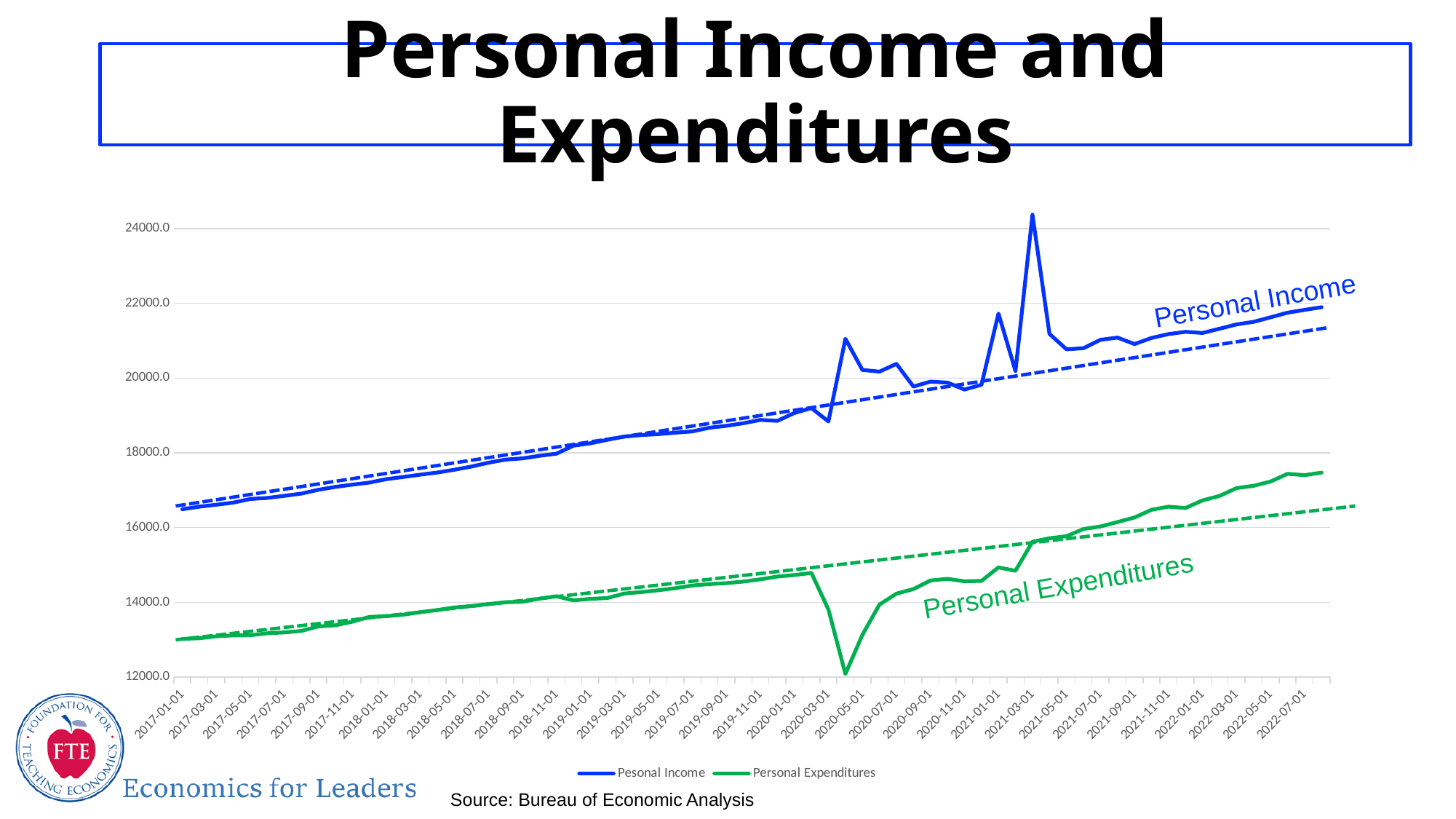
Is the value of Personal Expenditures at 2022-07-01 greater or less than 16000? greater Which series has higher values throughout the chart, Personal Income or Personal Expenditures? Personal Income What colour is the Personal Expenditures line? Green Is the value of Personal Income at 2017-01-01 greater or less than 18000? less In which year does Personal Income reach its highest point? 2021 Is the peak value of Personal Income greater or less than 22000? greater What is the title of the chart on the slide? Personal Income and Expenditures How many series does the legend list? 2 What kind of chart is shown on the slide? Line chart Do the Personal Income and Personal Expenditures lines generally rise or fall from 2017 to 2022? Rise In which year does Personal Expenditures reach its lowest point? 2020